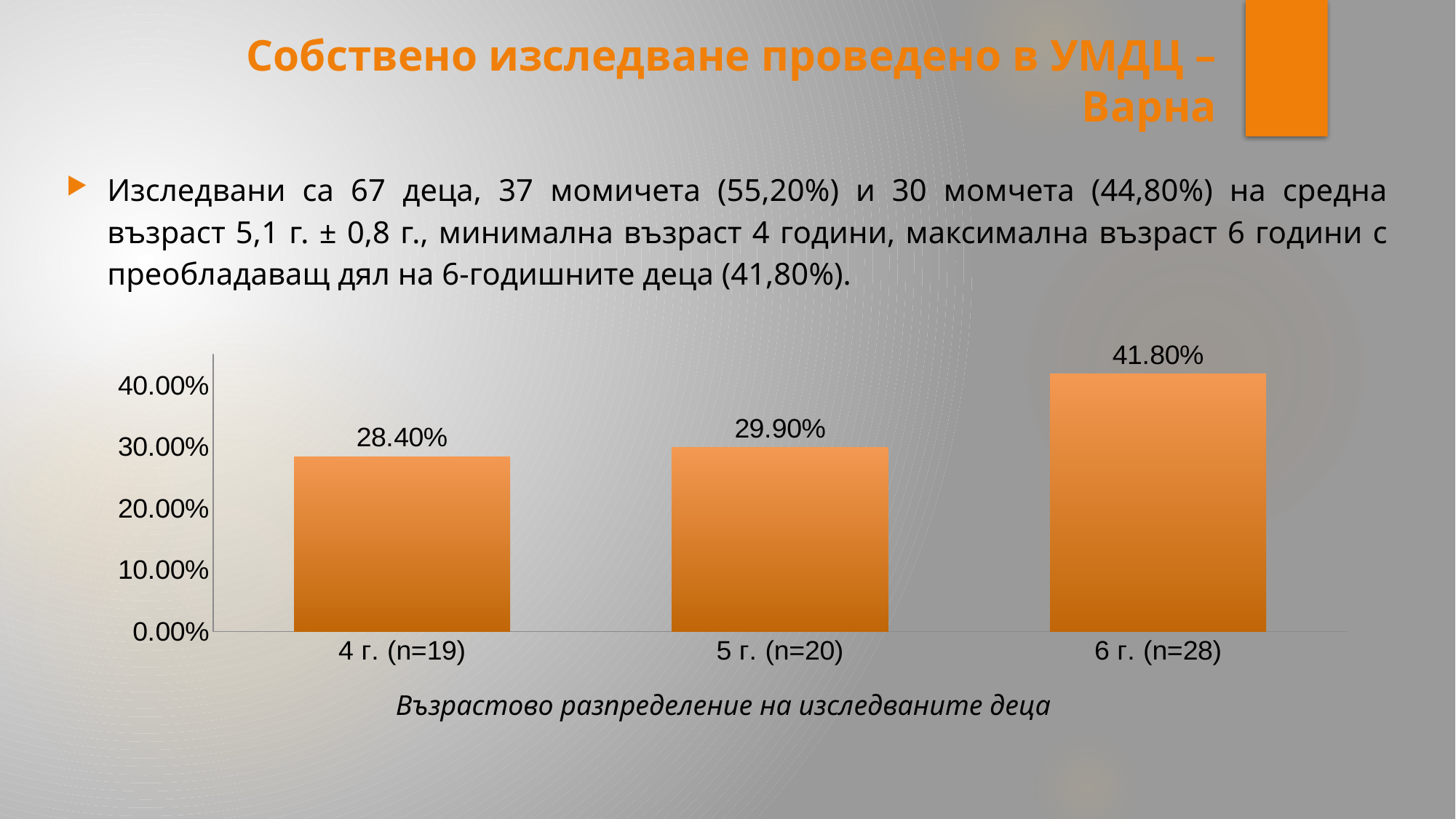
Which category has the lowest value? 4 г. (n=19) What is the value for the 5 г. (n=20) category? 29.90% Do the values rise or fall from left to right along the x axis? rise Which category has the highest value? 6 г. (n=28) How many categories are shown in the chart? 3 What is the difference between the values for 5 г. (n=20) and 4 г. (n=19)? 1.50% Which is larger, the value for 6 г. (n=28) or the value for 5 г. (n=20)? 6 г. (n=28) What is the value for the 4 г. (n=19) category? 28.40% Is the value for 6 г. (n=28) greater or less than 40.00%? greater What kind of chart is shown on the slide? bar chart What is the value for the 6 г. (n=28) category? 41.80% What is the difference between the values for 6 г. (n=28) and 4 г. (n=19)? 13.40%